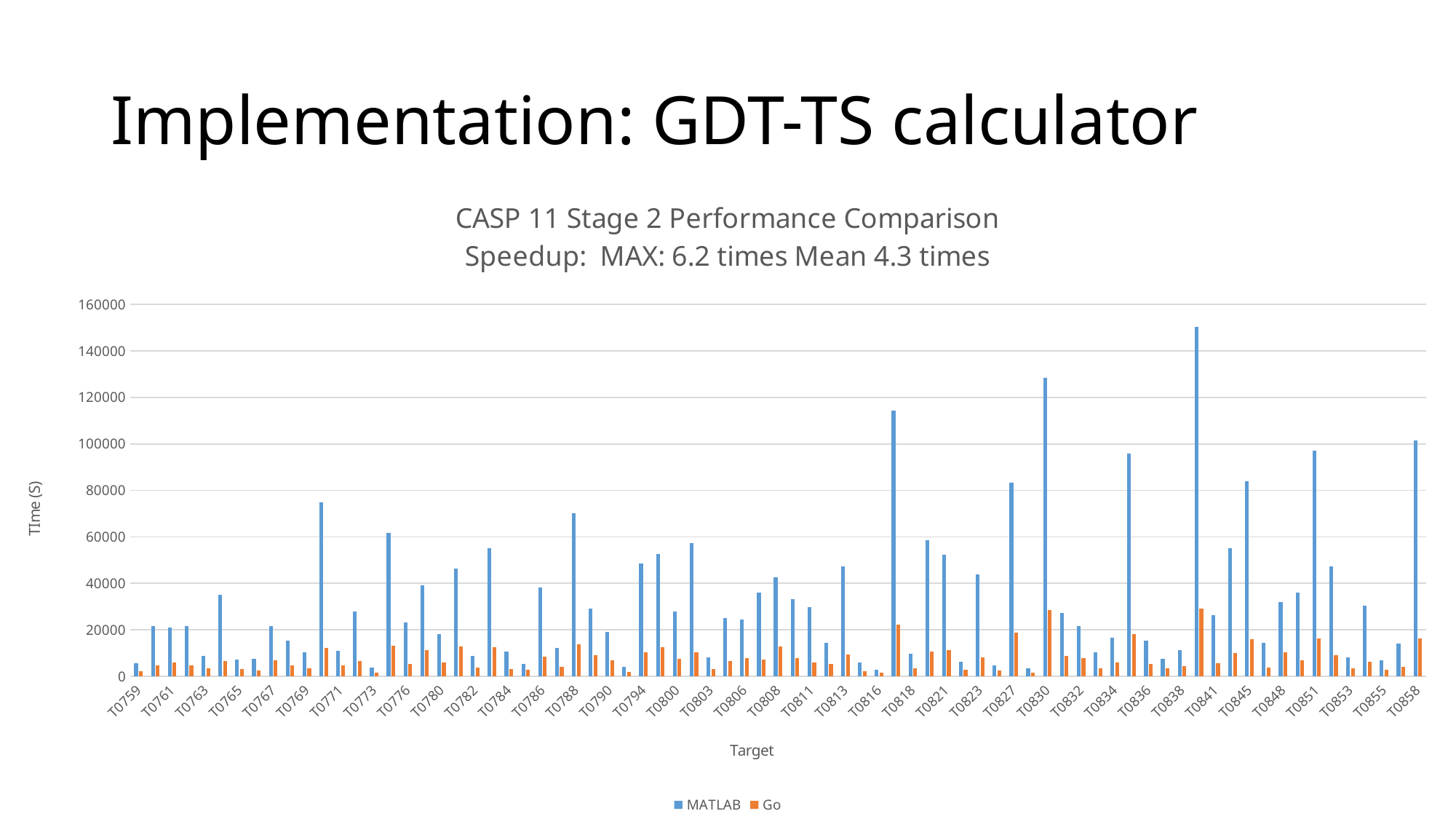
How many series does the legend list? 2 What kind of chart is shown on the slide? bar chart Is the MATLAB value for T0830 greater or less than 120000? greater Is the Go value for T0830 greater or less than 20000? greater Is the MATLAB value for T0771 greater or less than 80000? less Which has the larger MATLAB value, T0851 or T0845? T0851 Which series are listed in the chart legend? MATLAB and Go What is the title of the chart's vertical axis? TIme (S) Which has the larger MATLAB value, T0830 or T0818? T0830